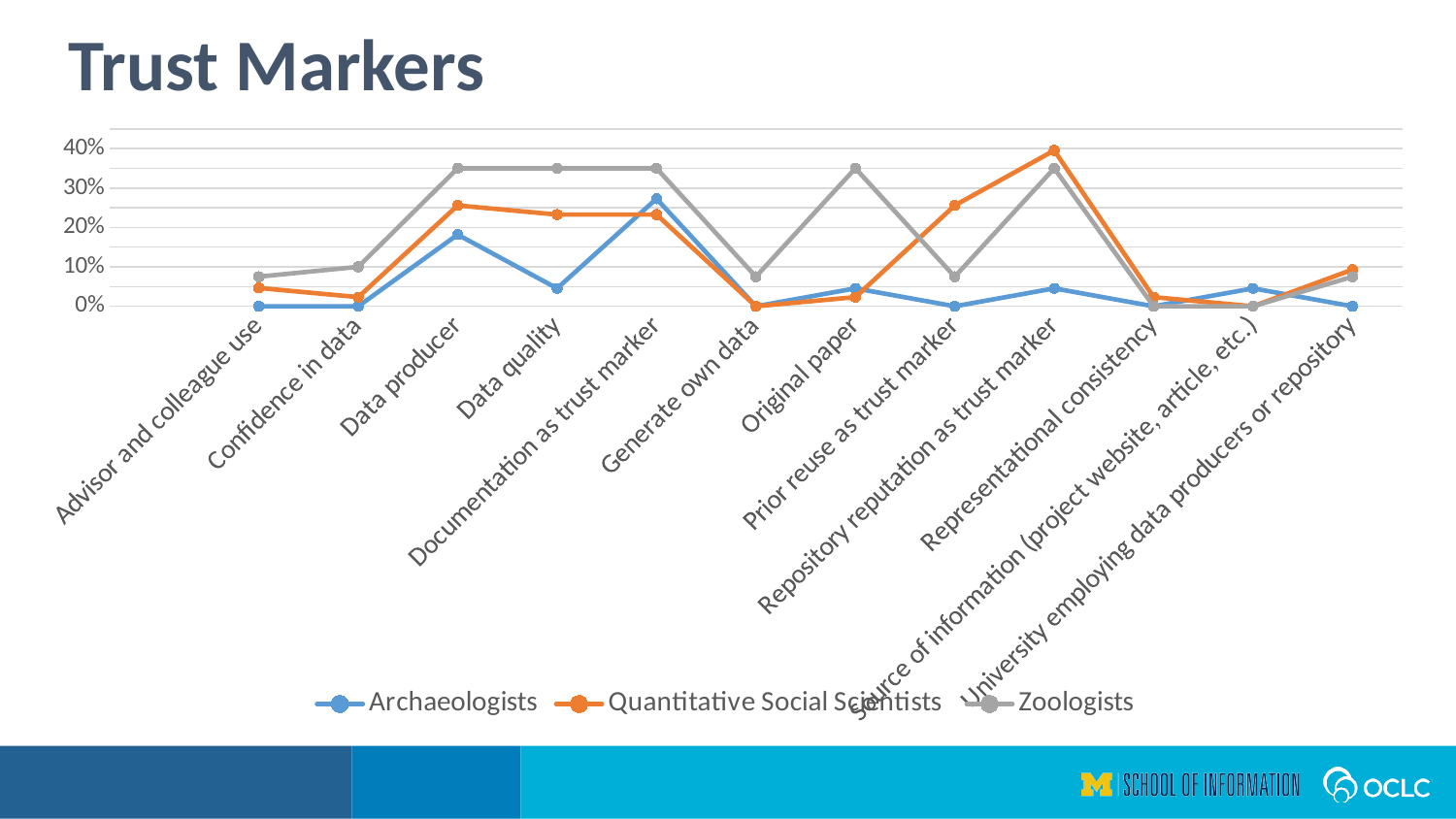
For Prior reuse as trust marker, which series has the larger value: Quantitative Social Scientists or Zoologists? Quantitative Social Scientists Is the Quantitative Social Scientists value for Repository reputation as trust marker greater or less than 30%? greater How many series does the legend list? 3 What kind of chart is shown on the slide? Line chart How many categories are shown along the x axis? 12 What is the title of the chart? Trust Markers For which category is the Archaeologists value highest? Documentation as trust marker For Data quality, which series has the larger value: Zoologists or Quantitative Social Scientists? Zoologists Is the Archaeologists value for Data quality greater or less than 10%? less Is the Zoologists value for Data producer greater or less than 30%? greater For which category is the Quantitative Social Scientists value highest? Repository reputation as trust marker For Original paper, which series has the larger value: Zoologists or Archaeologists? Zoologists